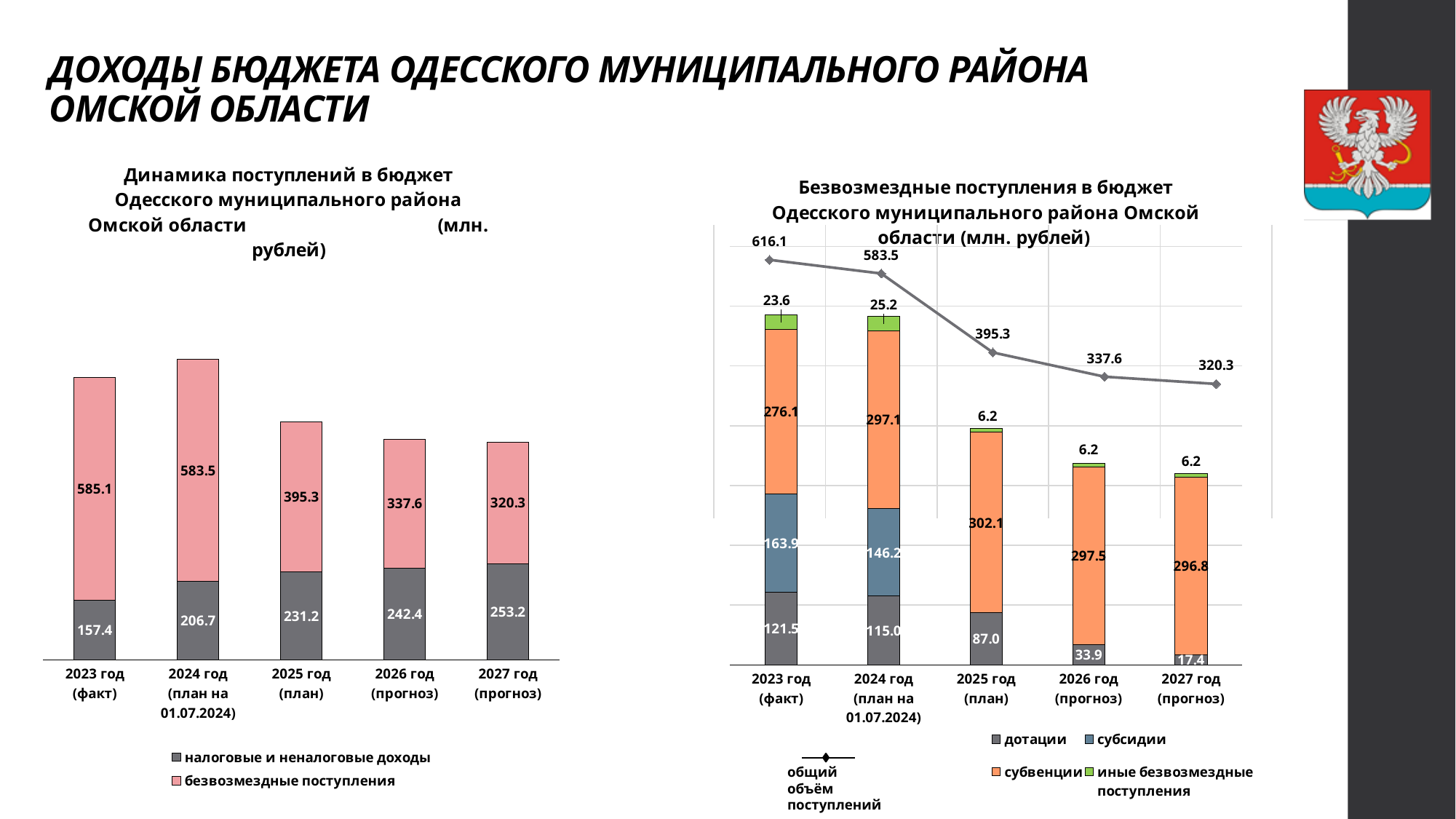
In the right chart (Безвозмездные поступления в бюджет), what is the difference between дотации in 2023 год (факт) and 2027 год (прогноз)? 104.1 In the left chart (Динамика поступлений в бюджет), which year has the highest value of безвозмездные поступления? 2023 год (факт) In the left chart (Динамика поступлений в бюджет), what is the total of the stacked bar for 2027 год (прогноз)? 573.5 In the left chart (Динамика поступлений в бюджет), what is the value of налоговые и неналоговые доходы for 2023 год (факт)? 157.4 In the left chart (Динамика поступлений в бюджет), what is the value of безвозмездные поступления for 2026 год (прогноз)? 337.6 In the right chart (Безвозмездные поступления в бюджет), how many years are shown on the x axis? 5 What type of chart is the right chart (Безвозмездные поступления в бюджет)? Stacked bar chart with a line In the right chart (Безвозмездные поступления в бюджет), what is the value of общий объём поступлений for 2023 год (факт)? 616.1 In the left chart (Динамика поступлений в бюджет), how do the values of налоговые и неналоговые доходы change from 2023 to 2027? They rise In the right chart (Безвозмездные поступления в бюджет), what is the value of субвенции for 2025 год (план)? 302.1 In the right chart (Безвозмездные поступления в бюджет), which is larger: субсидии in 2023 год (факт) or субсидии in 2024 год (план на 01.07.2024)? 2023 год (факт) In the left chart (Динамика поступлений в бюджет), how many series does the legend list? 2